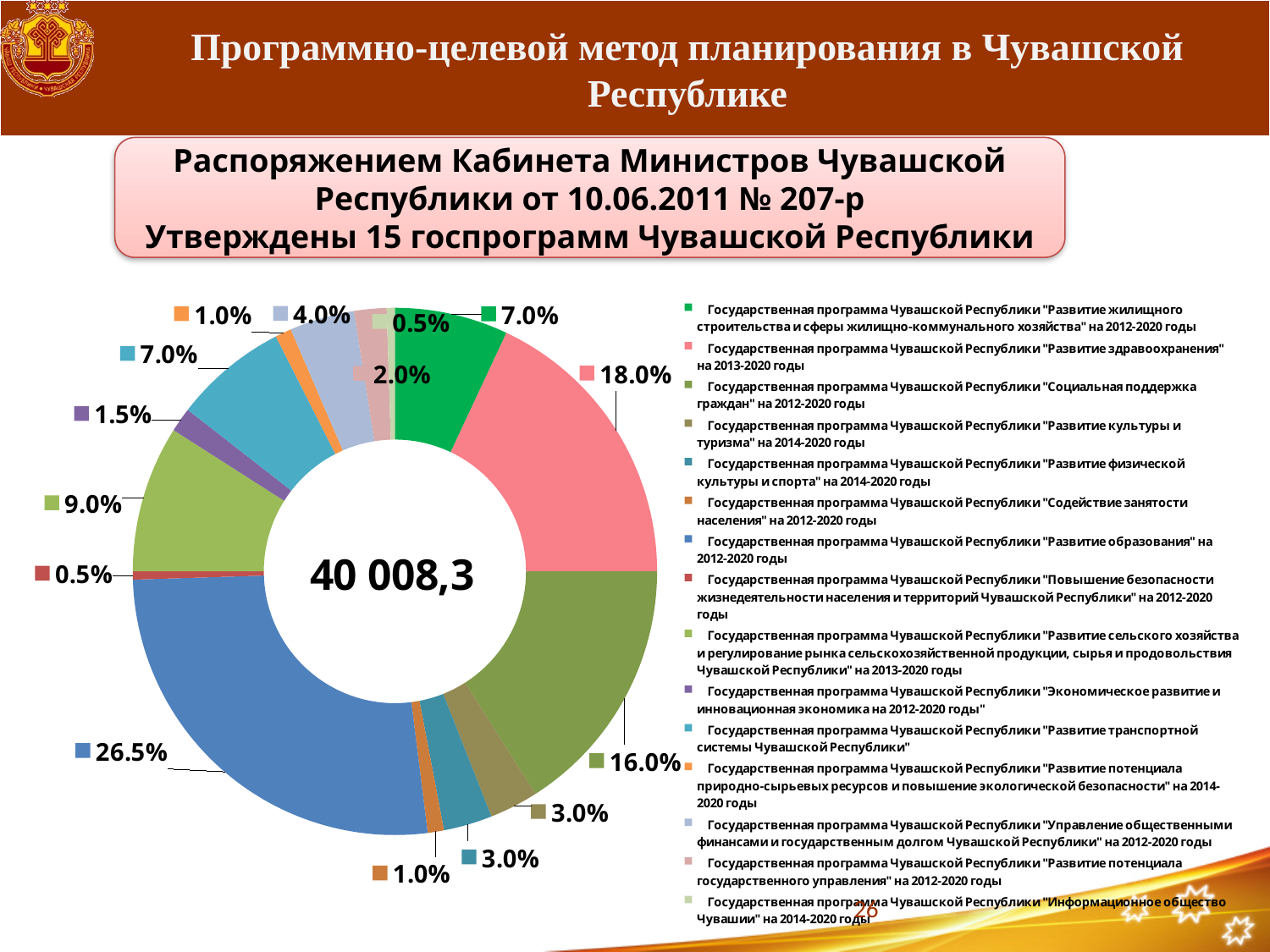
What is the smallest percentage value labelled on the doughnut chart? 0.5% What share is shown for the program "Социальная поддержка граждан"? 16.0% What is the difference in percentage points between the 26.5% slice and the 18.0% slice? 8.5 How many slices does the doughnut chart have? 15 Which program has the largest share of the doughnut chart? Развитие образования (26.5%) What is the largest percentage shown on the doughnut chart? 26.5% What share is shown for the program "Развитие здравоохранения"? 18.0% Which is larger: the share for "Развитие здравоохранения" or for "Социальная поддержка граждан"? Развитие здравоохранения (18.0%) How many entries does the legend of the chart list? 15 What type of chart is shown on the slide? Pie (doughnut) chart What number is printed in the centre of the doughnut chart? 40 008,3 What share is shown for the program "Развитие сельского хозяйства"? 9.0%